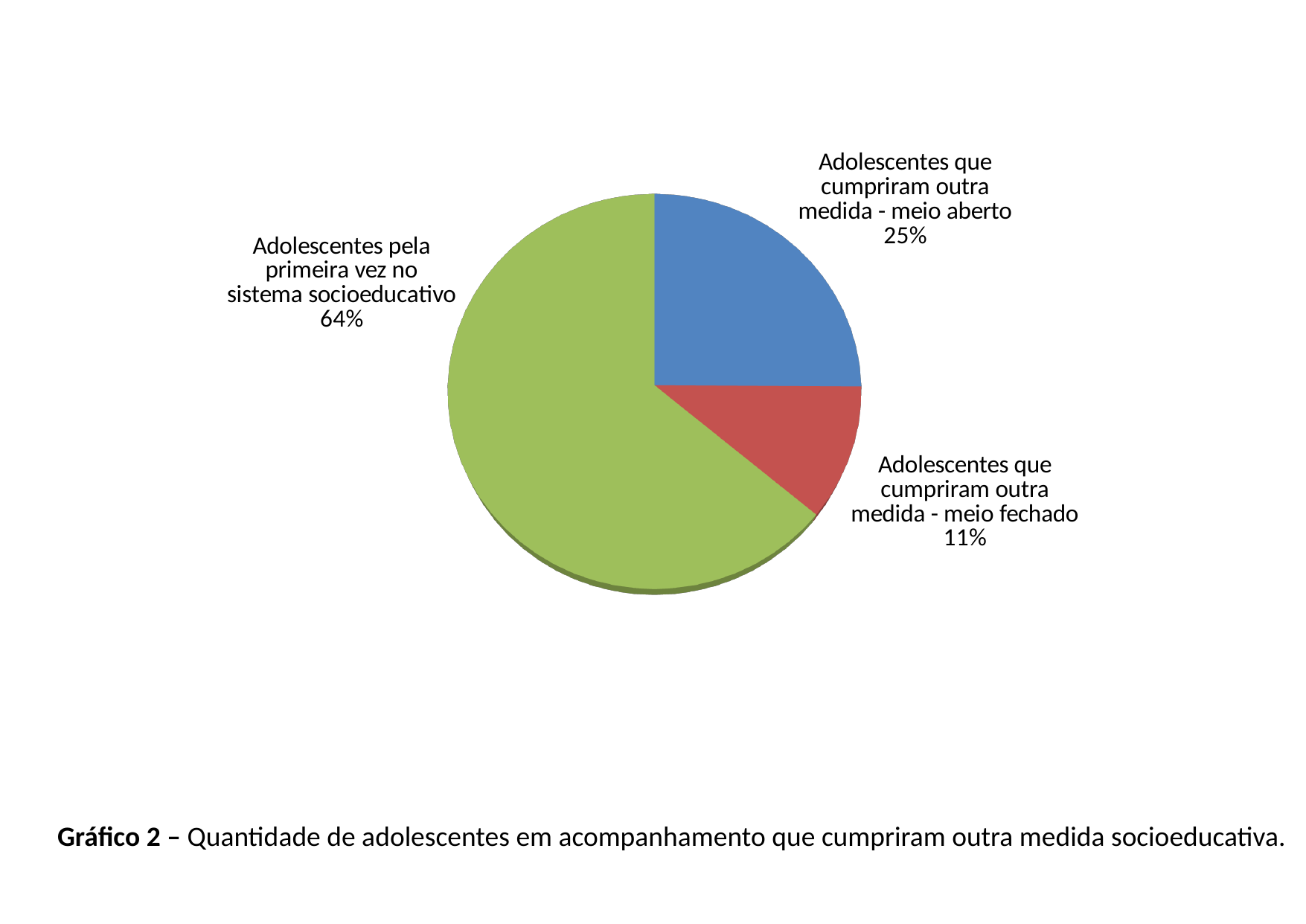
What percentage of the pie is 'Adolescentes que cumpriram outra medida - meio aberto'? 25% What percentage of the pie is 'Adolescentes que cumpriram outra medida - meio fechado'? 11% Which category has the largest share of the pie? Adolescentes pela primeira vez no sistema socioeducativo What is the caption of the chart shown below it? Gráfico 2 – Quantidade de adolescentes em acompanhamento que cumpriram outra medida socioeducativa. What is the difference in percentage points between the largest slice (64%) and the 'meio aberto' slice (25%)? 39 percentage points How many slices does the pie chart have? 3 Which is larger: the share for 'meio aberto' or the share for 'meio fechado'? Meio aberto What kind of chart is shown on the slide? Pie chart Which category has the smallest share of the pie? Adolescentes que cumpriram outra medida - meio fechado What percentage of the pie is 'Adolescentes pela primeira vez no sistema socioeducativo'? 64% What is the difference in percentage points between 'meio aberto' (25%) and 'meio fechado' (11%)? 14 percentage points What colour is the slice for 'Adolescentes pela primeira vez no sistema socioeducativo'? Green